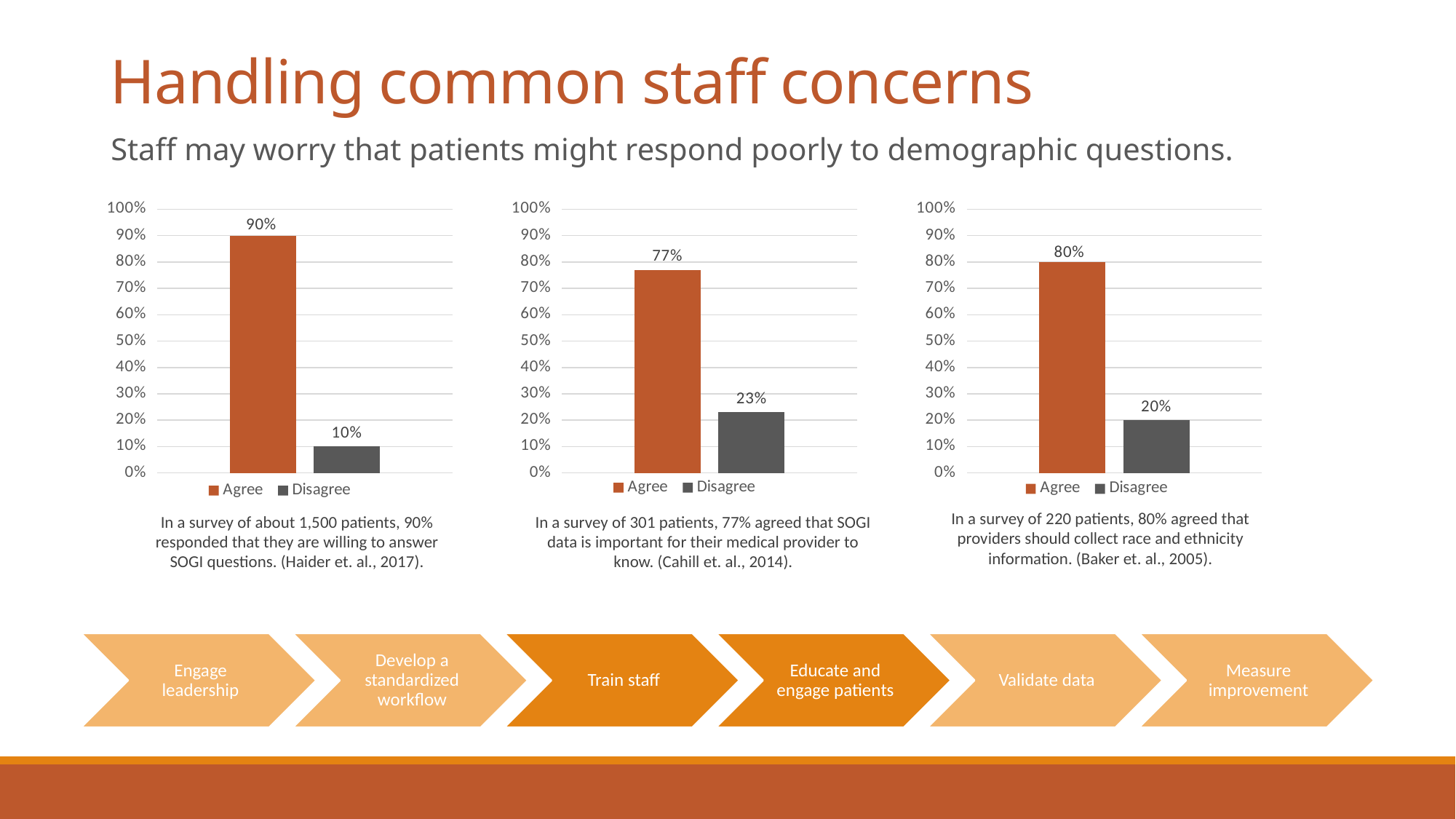
In the left chart, what is the value for Disagree? 10% In the right chart, what is the value for Agree? 80% In the right chart, what colour is the Agree bar? Orange In the right chart, what is the value for Disagree? 20% What kind of chart is the left chart? Bar chart In the middle chart, what is the value for Agree? 77% In the left chart, what is the value for Agree? 90% In the right chart, which is larger, Agree or Disagree? Agree In the middle chart, what is the value for Disagree? 23% How many series does the legend of the middle chart list? 2 In the middle chart, what is the difference between Agree and Disagree? 54% In the left chart, which series has the lowest value? Disagree